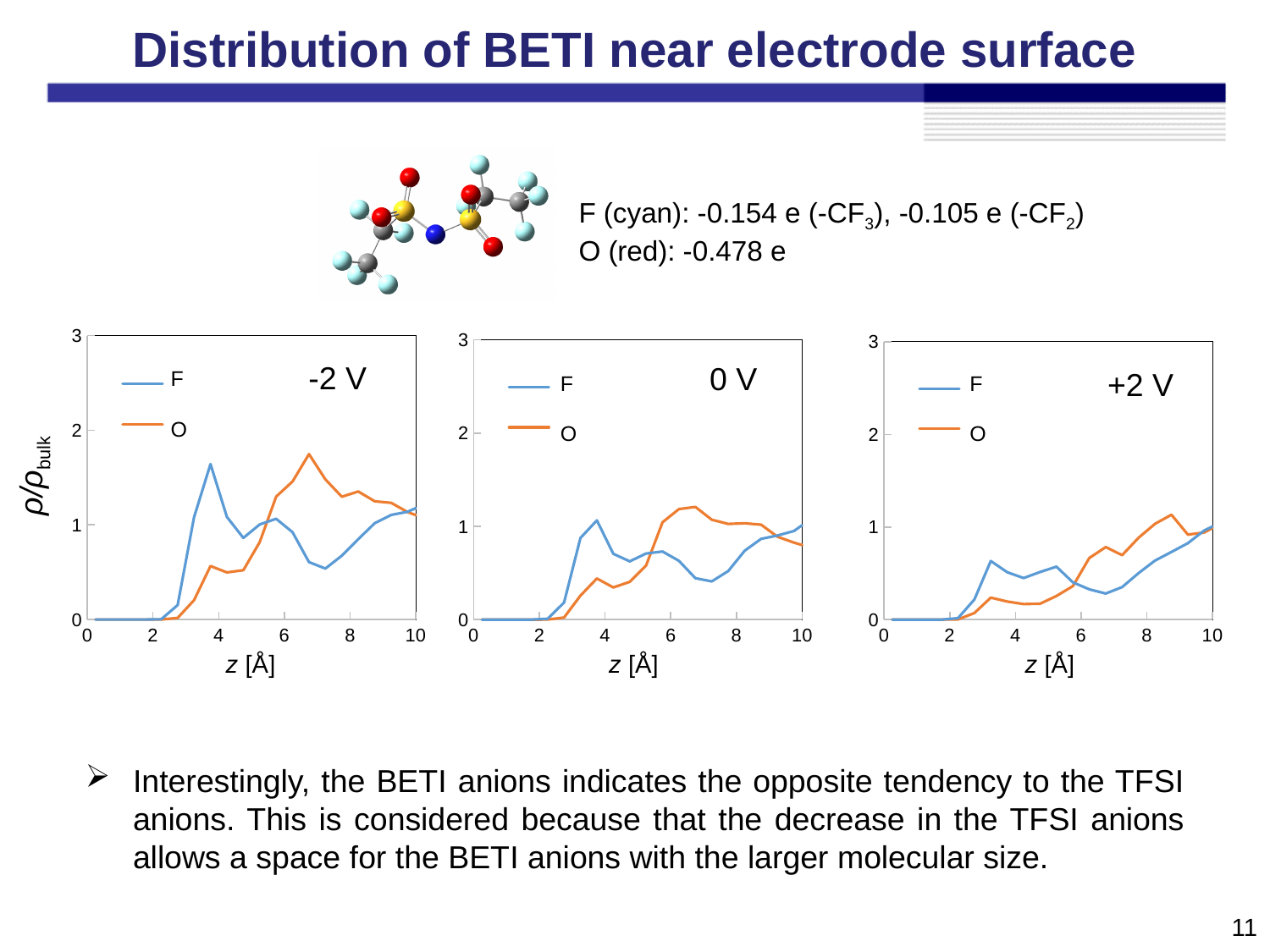
In the -2 V chart, is the peak value of the O series greater or less than 1? greater How many series does the legend of the 0 V chart list? 2 In the 0 V chart, is the peak value of the O series greater or less than 2? less In the +2 V chart, does the O series generally rise or fall between z = 2 Å and z = 8 Å? rise In the +2 V chart, at z = 8 Å, which series has the larger value, F or O? O In the +2 V chart, which series is drawn in orange? O What kind of chart is the -2 V chart? line chart What is the x-axis label of the -2 V chart? z [Å] In the +2 V chart, is the peak value of the F series greater or less than 1? less In the 0 V chart, at z = 4 Å, which series has the larger value, F or O? F Across the three charts, which voltage shows the highest peak of the O series? -2 V